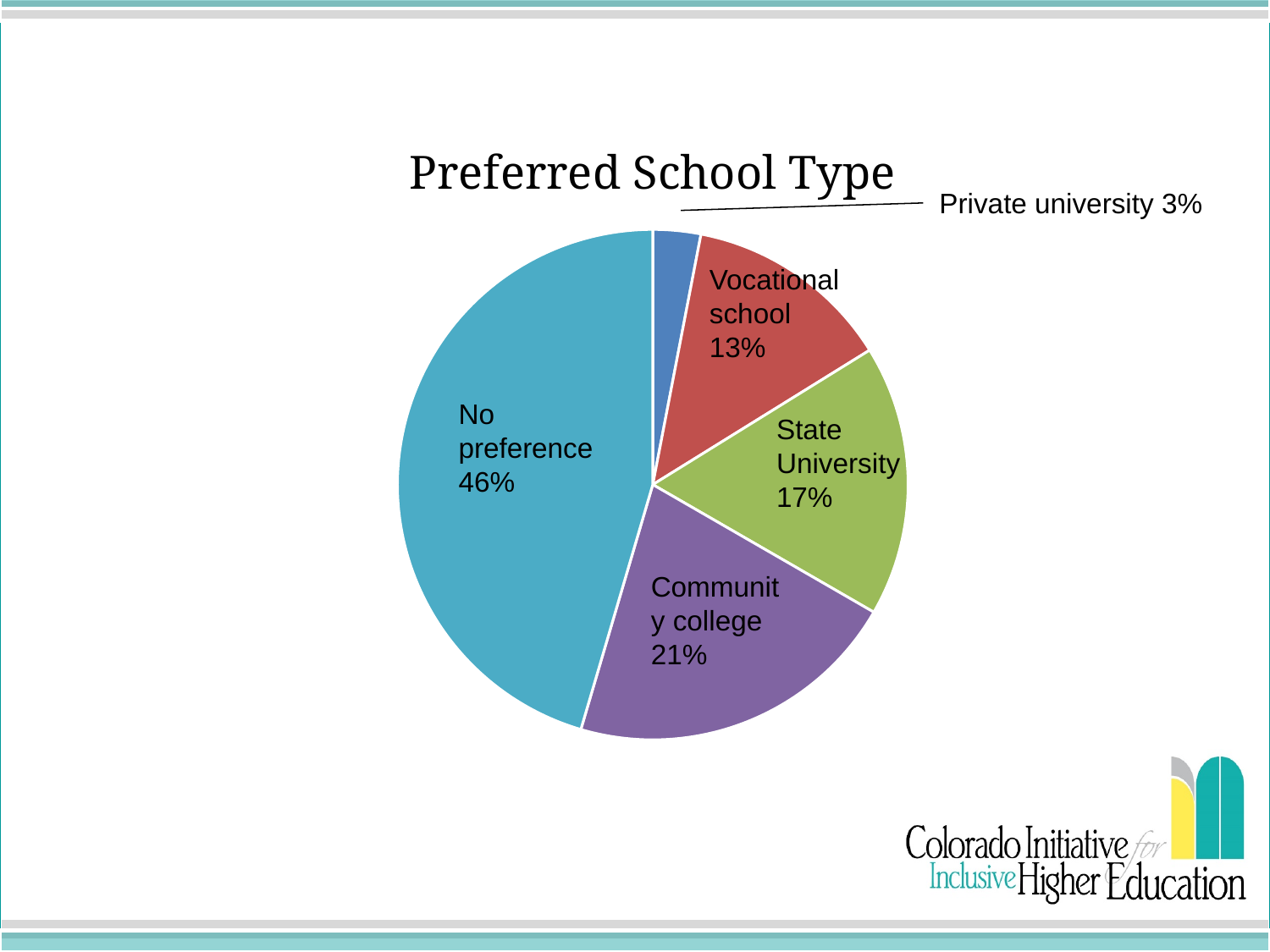
What kind of chart is shown on the slide? Pie chart Which category has the smallest slice of the pie? Private university What share of the pie is labelled "No preference"? 46% What percentage is shown for Private university? 3% Which category has the largest slice of the pie? No preference What percentage is shown for Vocational school? 13% How many slices does the pie chart have? 5 What percentage is shown for Community college? 21% What is the difference in percentage points between Community college and Vocational school? 8 What percentage is shown for State University? 17% Which is larger, the share for State University or the share for Vocational school? State University What is the title of the chart? Preferred School Type